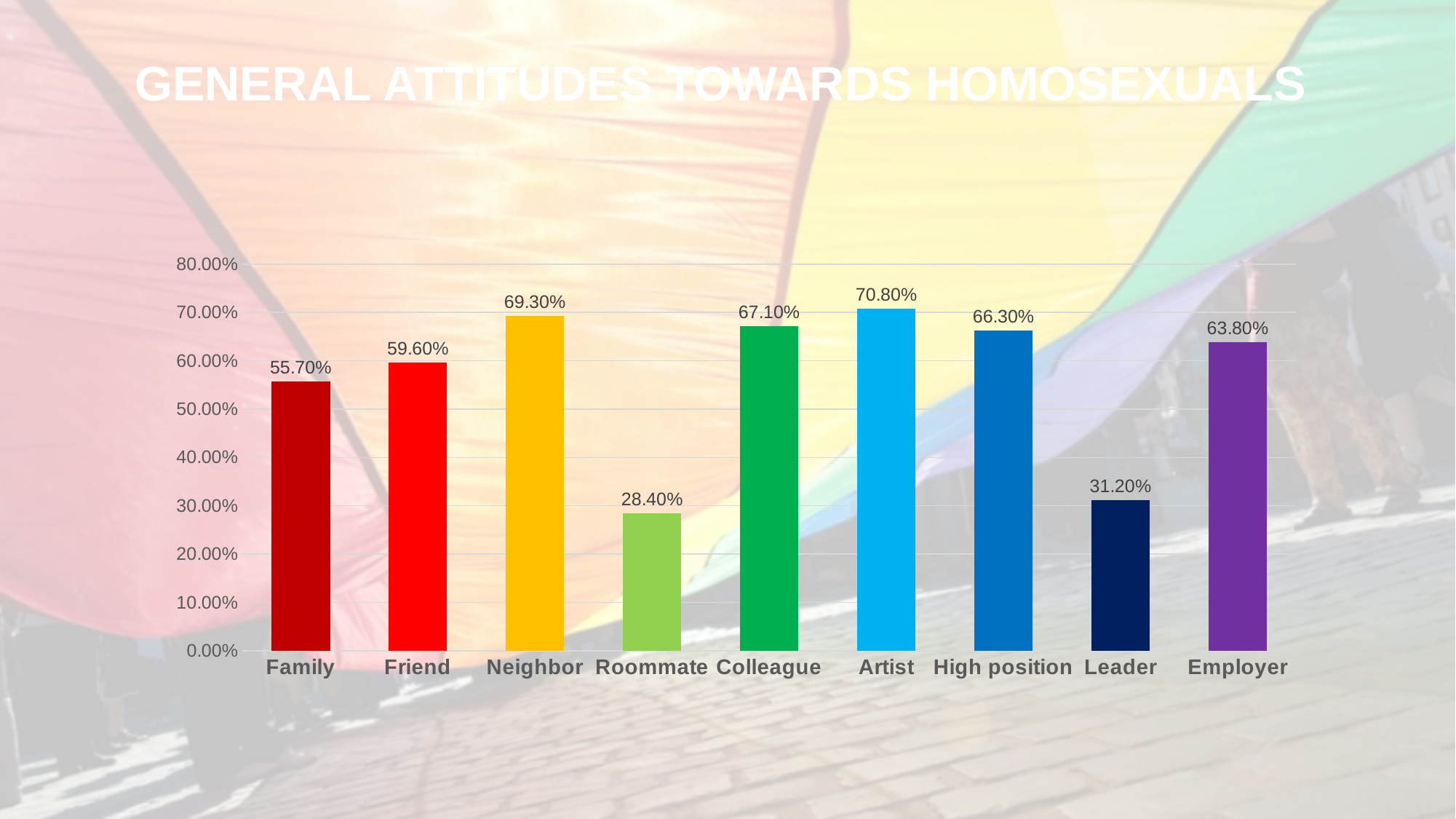
Which category has the highest value? Artist How many categories are shown on the x axis? 9 What is the difference between the values for Artist and Roommate? 42.40% What is the value for Neighbor? 69.30% What is the value for Leader? 31.20% What kind of chart is shown on the slide? bar chart Is the value for Family greater or less than 50.00%? greater Which category has the lowest value? Roommate What is the value for Employer? 63.80% Which is larger, the value for Colleague or the value for High position? Colleague What is the title of the chart? GENERAL ATTITUDES TOWARDS HOMOSEXUALS What is the difference between the values for Friend and Family? 3.90%